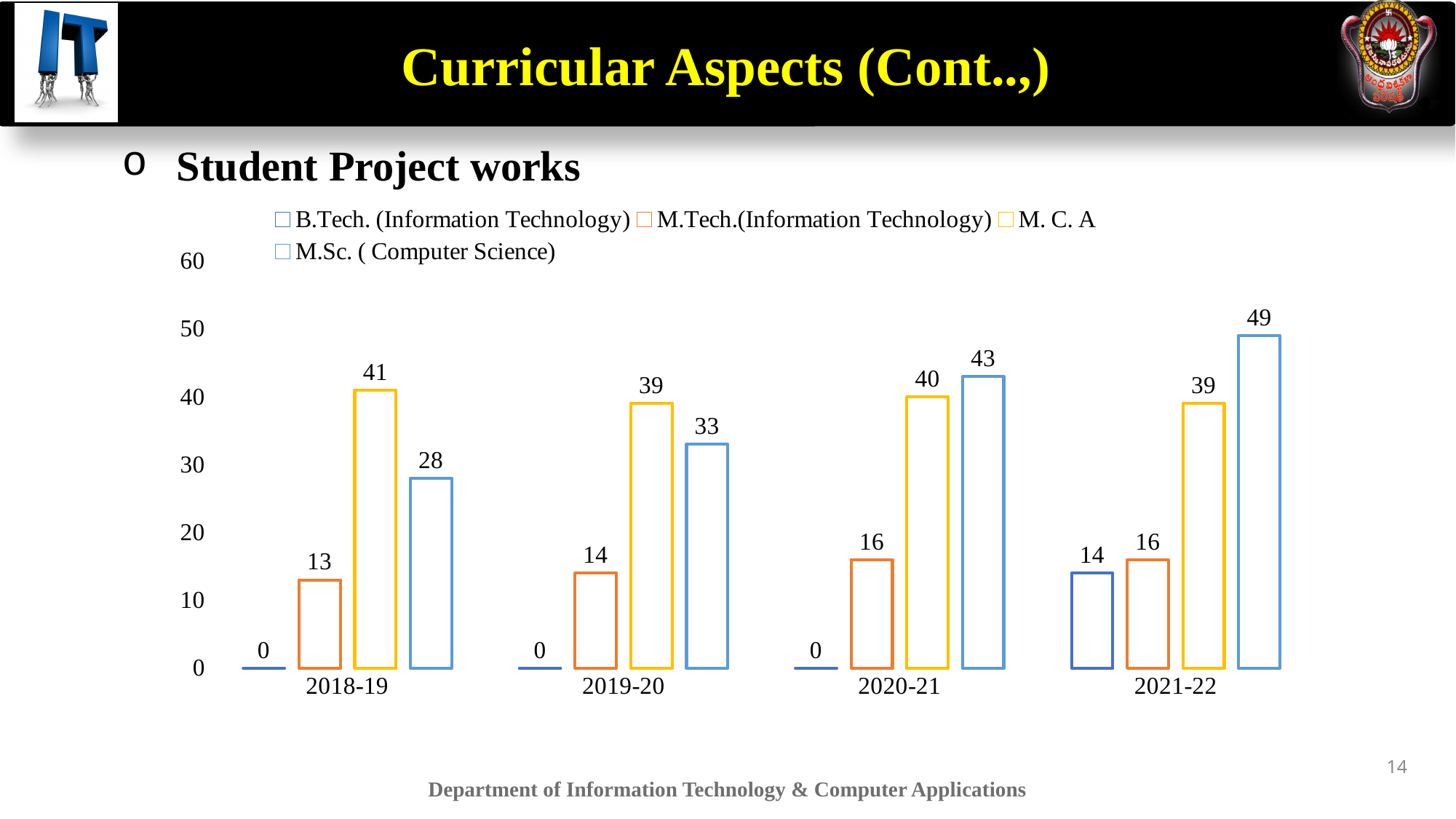
What is the value for B.Tech. (Information Technology) in 2021-22? 14 What is the value for M.Sc. ( Computer Science) in 2021-22? 49 How many academic years are shown on the x axis? 4 What is the value for M.Tech.(Information Technology) in 2020-21? 16 Which is larger in 2019-20, the M. C. A value or the M.Sc. ( Computer Science) value? M. C. A What type of chart is shown on the slide? bar chart In which year is the M.Sc. ( Computer Science) value highest? 2021-22 What is the difference between the M.Sc. ( Computer Science) value and the M. C. A value in 2020-21? 3 What is the value for M. C. A in 2018-19? 41 Does the M.Sc. ( Computer Science) value rise or fall from 2018-19 to 2021-22? rise In which year is the M.Sc. ( Computer Science) value lowest? 2018-19 How many series does the legend list? 4